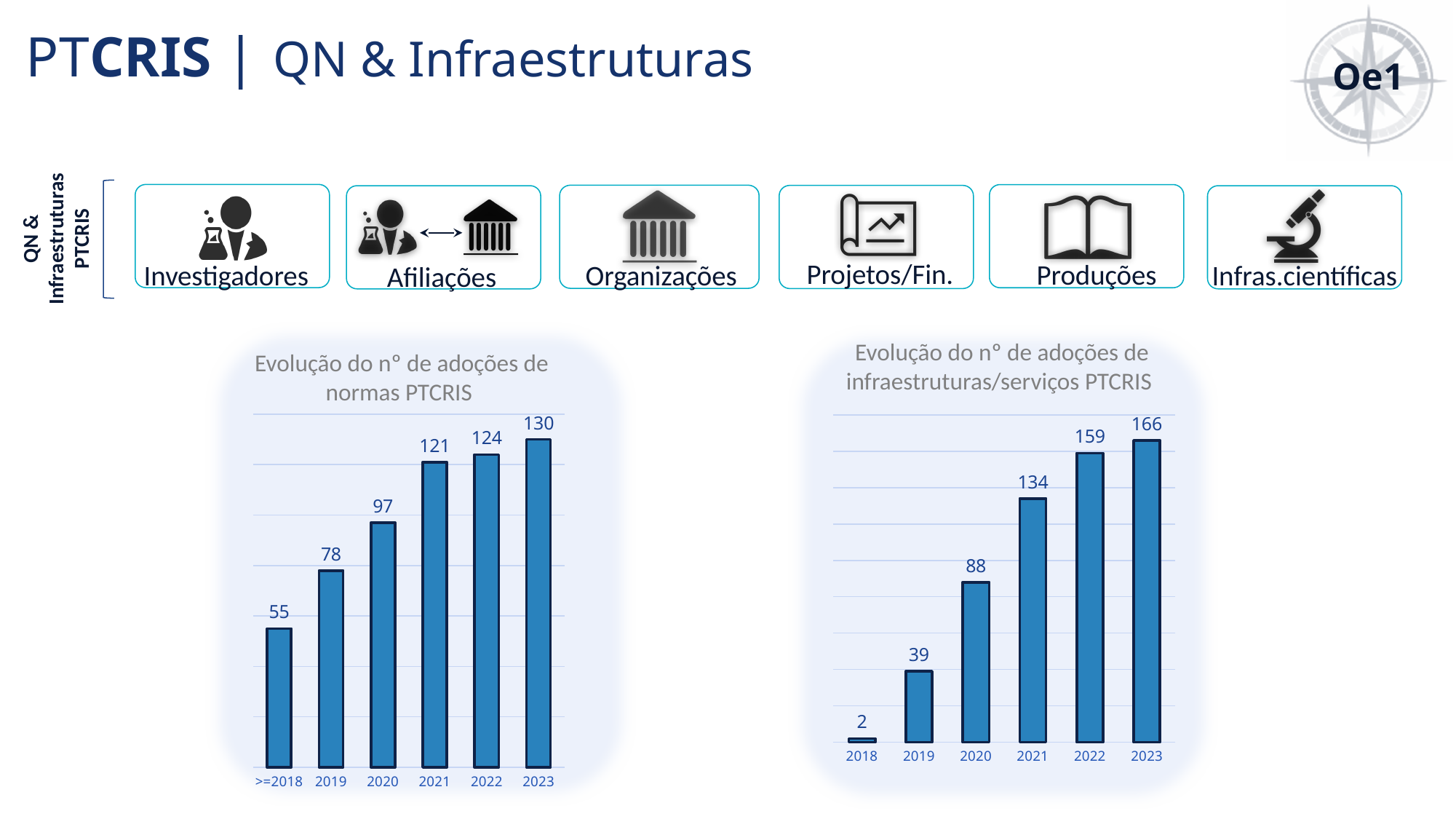
In the chart 'Evolução do nº de adoções de normas PTCRIS', which year has the highest value? 2023 How many bars are shown in the chart 'Evolução do nº de adoções de infraestruturas/serviços PTCRIS'? 6 In the chart 'Evolução do nº de adoções de infraestruturas/serviços PTCRIS', which year has the lowest value? 2018 In the chart 'Evolução do nº de adoções de infraestruturas/serviços PTCRIS', do the values rise or fall from 2018 to 2023? Rise In the chart 'Evolução do nº de adoções de infraestruturas/serviços PTCRIS', what is the value for 2018? 2 In the chart 'Evolução do nº de adoções de normas PTCRIS', what is the value for 2020? 97 In the chart 'Evolução do nº de adoções de normas PTCRIS', what is the difference between the values for 2023 and 2022? 6 Which is larger: the value for 2021 in the left chart (normas PTCRIS) or the value for 2021 in the right chart (infraestruturas/serviços PTCRIS)? The right chart (134) What type of chart is 'Evolução do nº de adoções de normas PTCRIS'? Bar chart In the chart 'Evolução do nº de adoções de normas PTCRIS', what is the value for >=2018? 55 In the chart 'Evolução do nº de adoções de infraestruturas/serviços PTCRIS', what is the difference between the values for 2022 and 2021? 25 In the chart 'Evolução do nº de adoções de infraestruturas/serviços PTCRIS', what is the value for 2021? 134